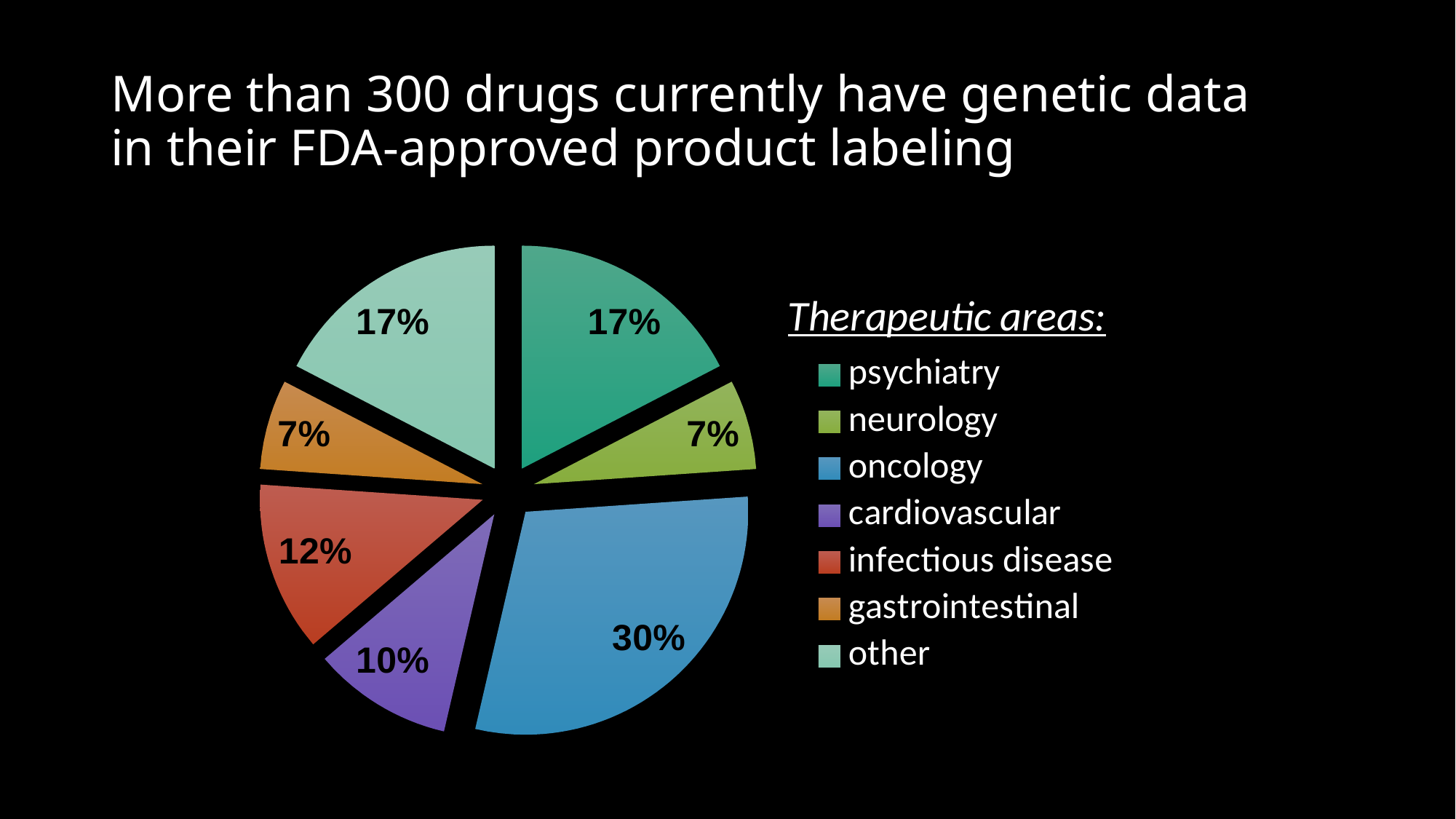
What percentage is shown for infectious disease? 12% Which is larger, the share for cardiovascular or the share for neurology? cardiovascular How many slices does the pie chart have? 7 What is the combined share of psychiatry and neurology? 24% What kind of chart is shown on the slide? pie chart What is the heading above the legend? Therapeutic areas: What percentage is shown for psychiatry? 17% What percentage is shown for gastrointestinal? 7% Which therapeutic area has the largest slice of the pie? oncology What percentage is shown for cardiovascular? 10% What is the difference in percentage points between oncology and infectious disease? 18 What share of the pie does oncology account for? 30%